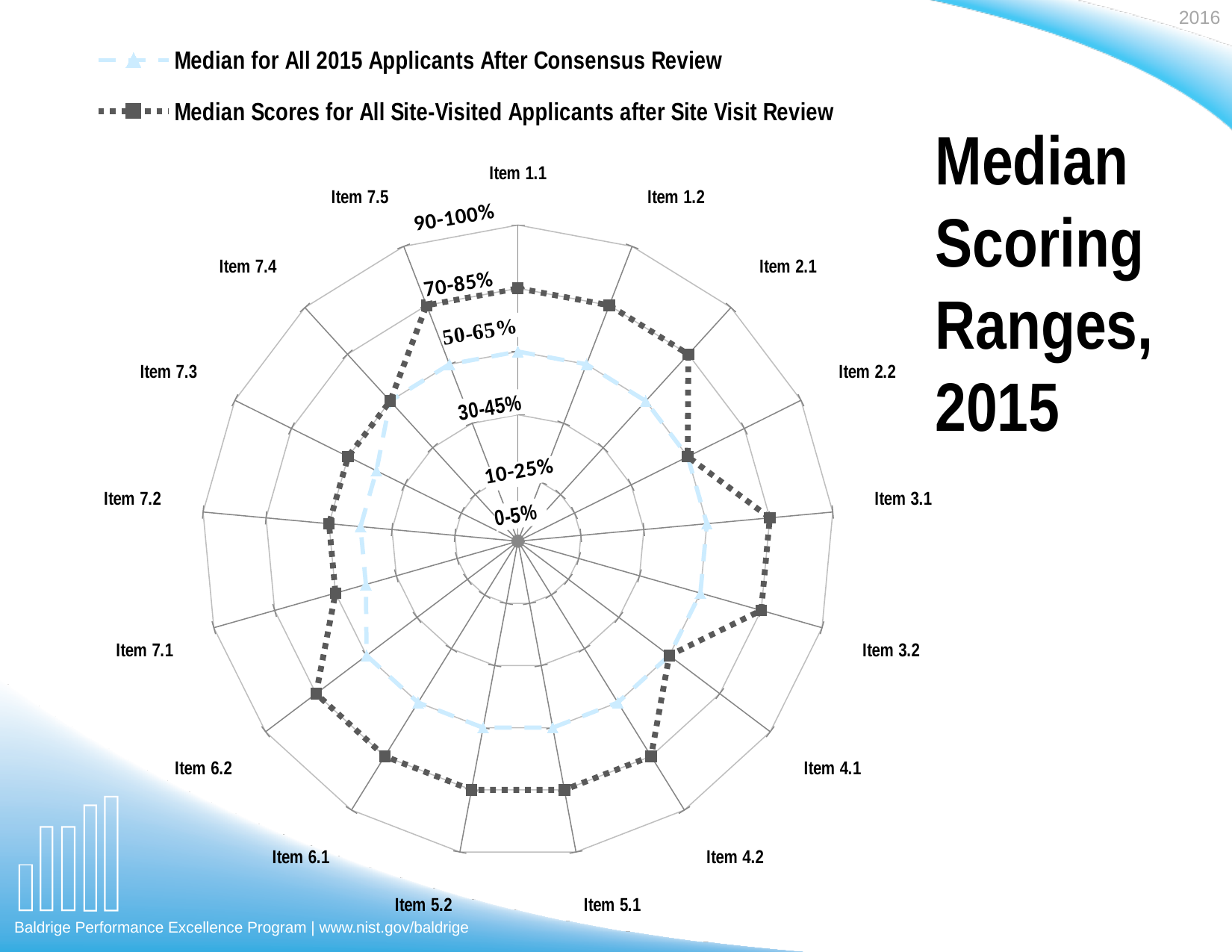
Which series is represented by the dark dotted line with square markers? Median Scores for All Site-Visited Applicants after Site Visit Review How many items (categories) are plotted around the radar chart? 17 What is the title of the chart on the slide? Median Scoring Ranges, 2015 What kind of chart is shown on the slide? Radar chart How many series does the legend list? 2 For Item 1.1, which series has the lower value? Median for All 2015 Applicants After Consensus Review What is the label of the outermost ring of the radar chart? 90-100% Does the site visit review series lie inside or outside the consensus review series for every item? Neither for every item: it is outside or on the same ring, coinciding with the consensus series at Items 2.2, 4.1 and 7.4 For Item 3.1, which series has the higher value: the consensus review median or the site visit review median? Median Scores for All Site-Visited Applicants after Site Visit Review